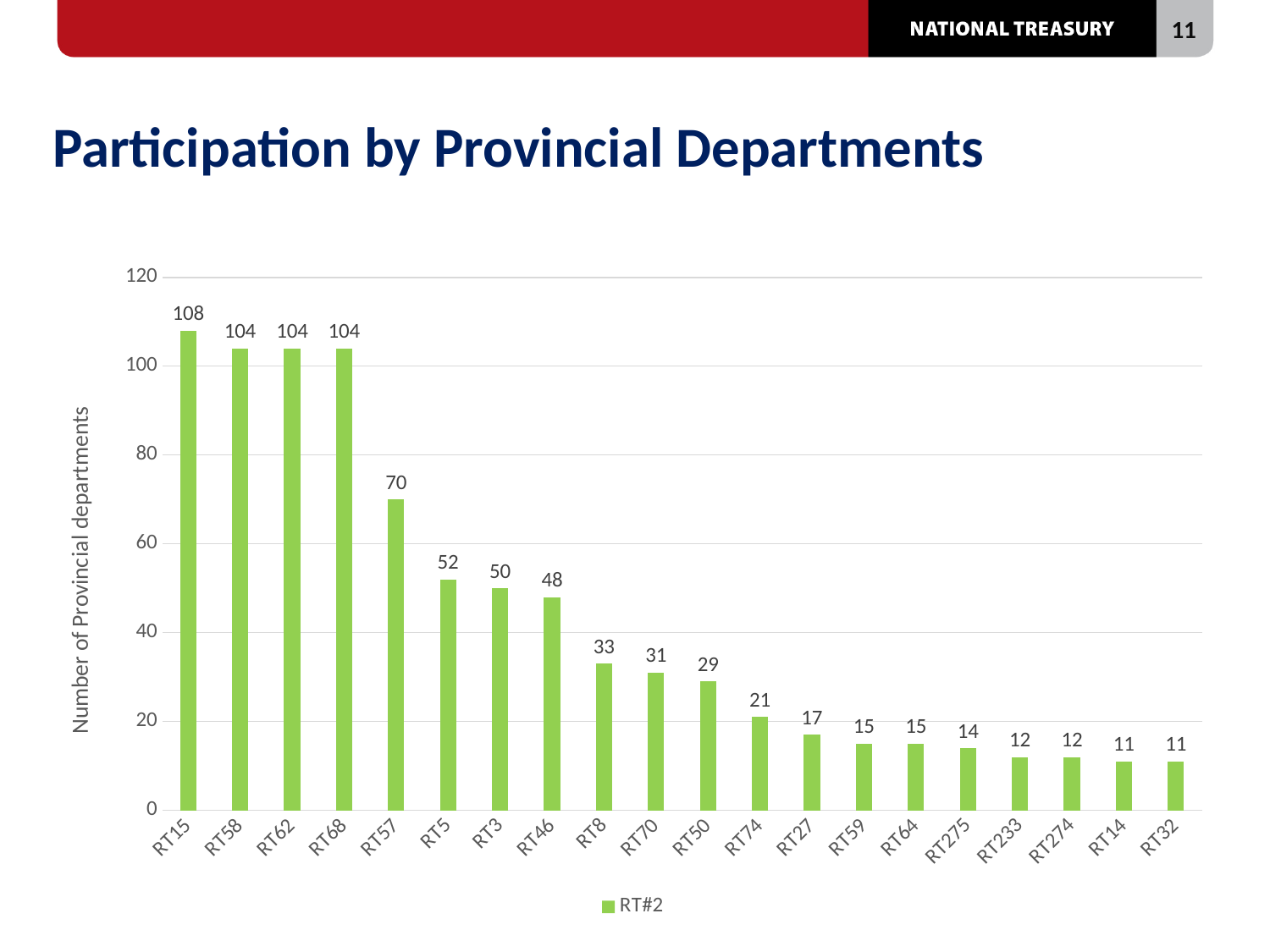
Which category has the highest value? RT15 What kind of chart is shown on the slide? Bar chart What is the value for RT46? 48 Is the value for RT3 greater or less than 40? greater How many categories are shown on the x axis? 20 What is the difference between the values for RT5 and RT8? 19 Which is larger, the value for RT70 or the value for RT50? RT70 What is the value for RT57? 70 What is the difference between the values for RT15 and RT57? 38 How many series does the legend list? 1 What is the label of the y axis? Number of Provincial departments What is the value for RT74? 21